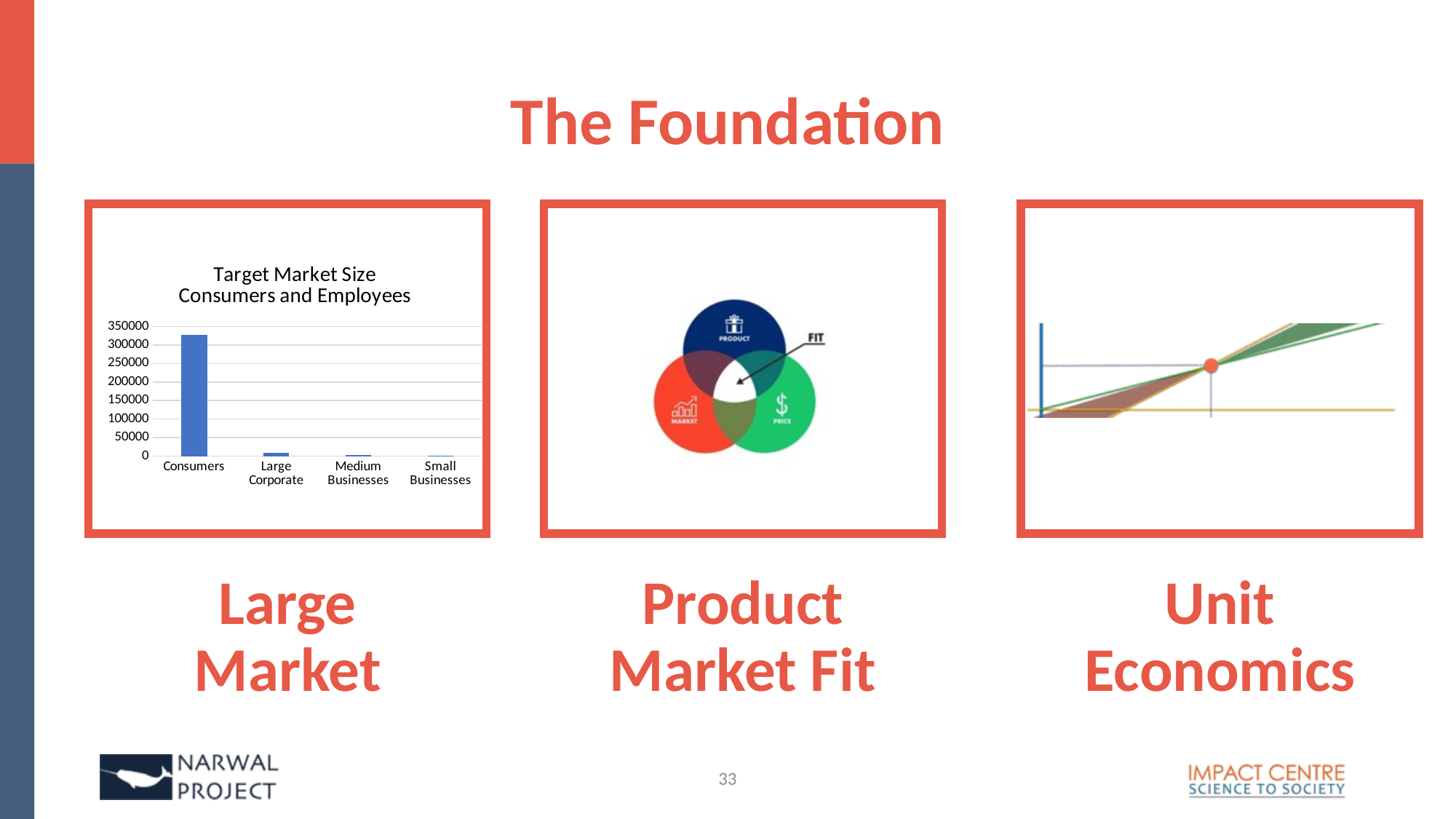
In the 'Target Market Size' bar chart, is the value for Medium Businesses greater or less than 50000? less How many categories are shown on the x axis of the 'Target Market Size' bar chart? 4 In the 'Target Market Size' bar chart, is the value for Consumers greater or less than 350000? less What is the title of the bar chart on the left of the slide? Target Market Size Consumers and Employees In the 'Target Market Size' bar chart, which is larger: Large Corporate or Small Businesses? Large Corporate What is the highest value shown on the y axis of the 'Target Market Size' bar chart? 350000 In the 'Target Market Size' bar chart, is the value for Consumers greater or less than 300000? greater In the 'Target Market Size' bar chart, which is larger: Consumers or Large Corporate? Consumers In the 'Target Market Size' bar chart, do the values generally rise or fall from left to right along the x axis? fall In the 'Target Market Size' bar chart, which category has the highest value? Consumers What kind of chart is shown in the 'Large Market' box on the left of the slide? bar chart